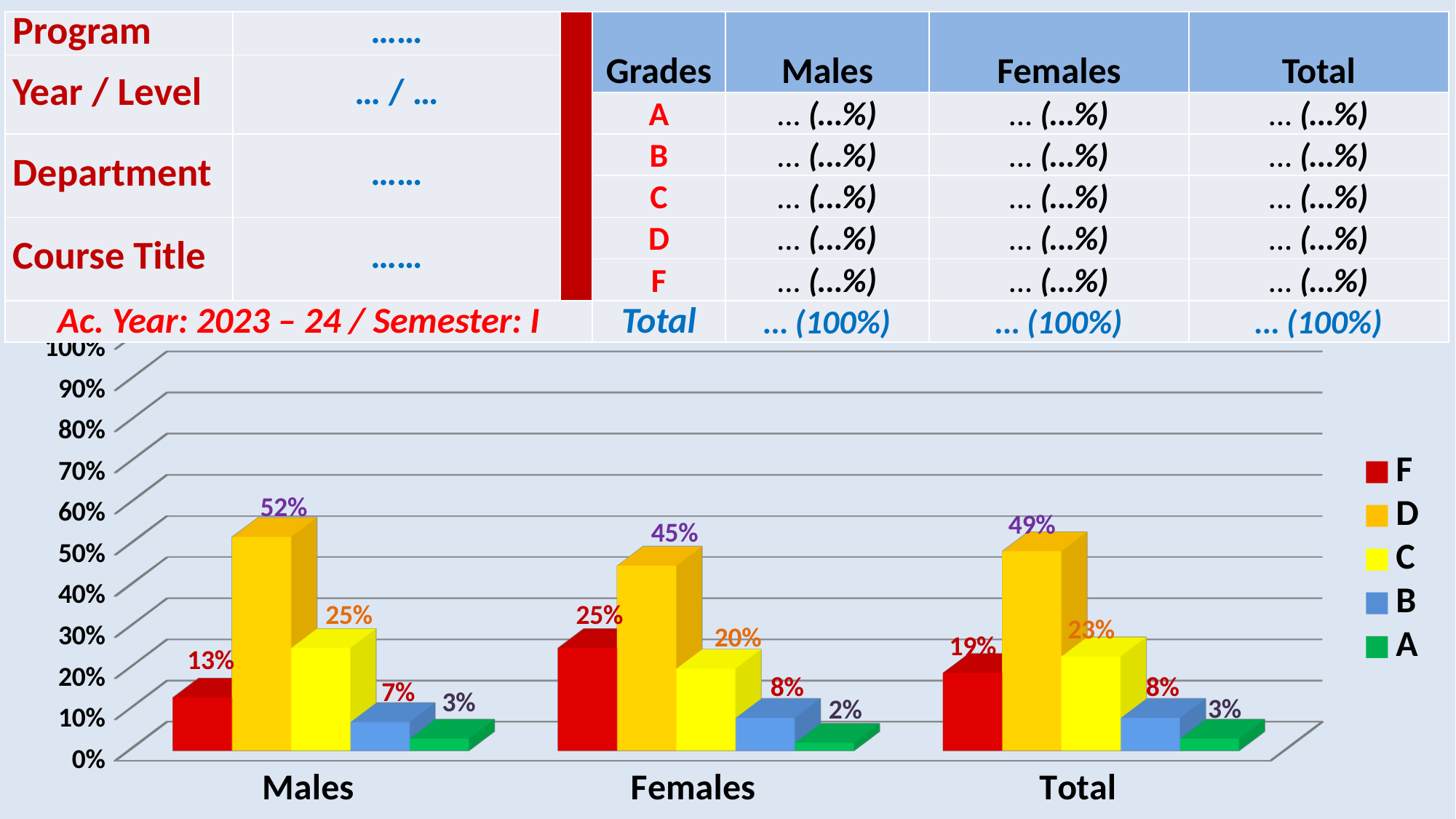
How many series does the legend list? 5 Which grade has the highest value in the Total group? D Which is larger: grade C for Males or grade C for Females? Males What kind of chart is shown on the slide? Bar chart What is the value for grade D in the Males group? 52% What is the difference between the grade D values for Males and Females? 7% Which grade has the lowest value in the Females group? A What colour represents grade D in the chart? Orange/yellow-orange How many groups are shown on the x axis? 3 What is the value for grade B in the Females group? 8% What is the value for grade F in the Females group? 25% What is the value for grade A in the Total group? 3%